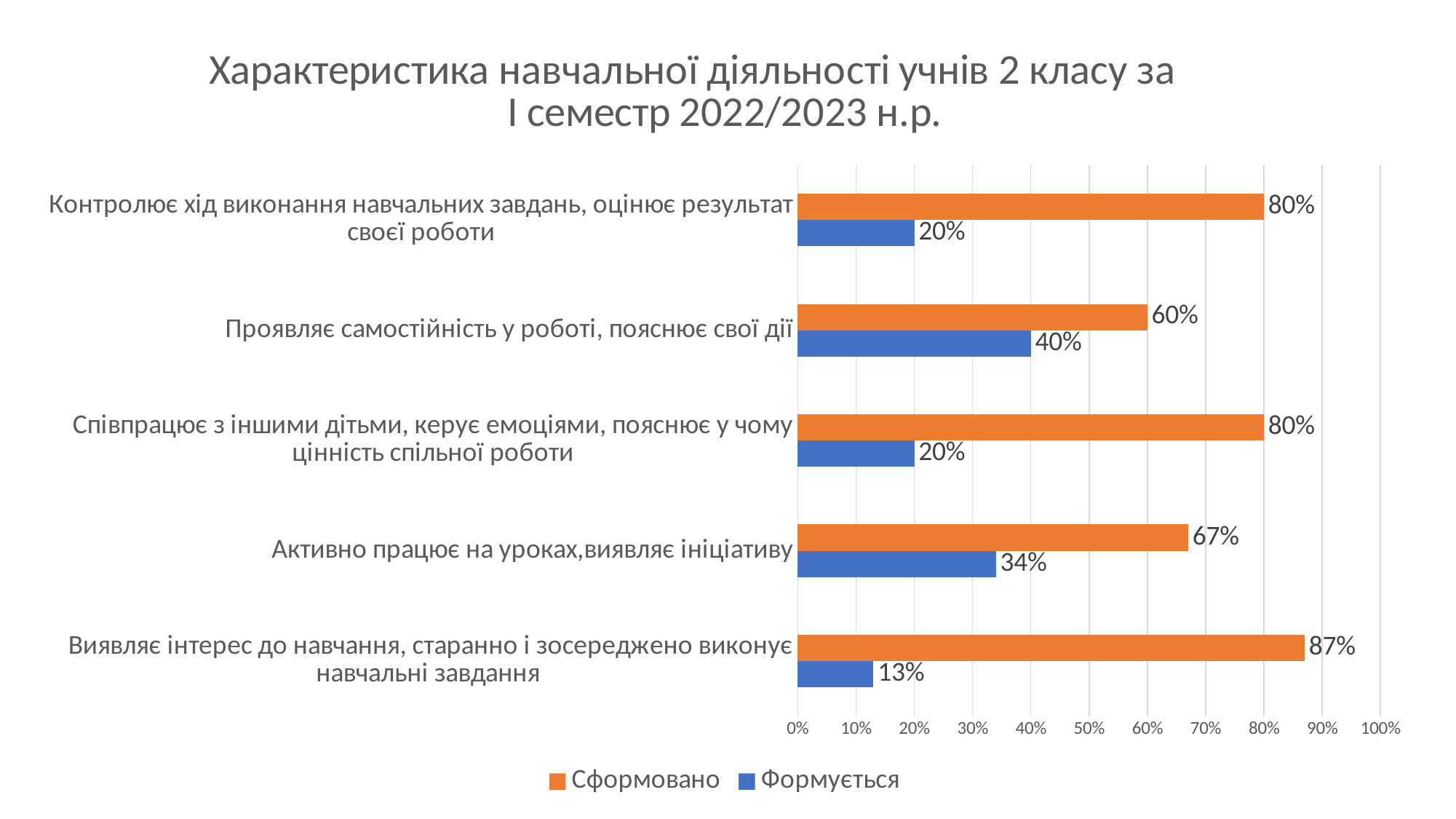
How many categories are shown on the chart? 5 Which category has the lowest "Сформовано" value? Проявляє самостійність у роботі, пояснює свої дії What kind of chart is shown on the slide? Bar chart What is the difference between the "Сформовано" and "Формується" values for "Активно працює на уроках,виявляє ініціативу"? 33% How many series does the legend list? 2 Which colour represents the "Формується" series? Blue Which is larger: the "Формується" value for "Проявляє самостійність у роботі, пояснює свої дії" or for "Контролює хід виконання навчальних завдань, оцінює результат своєї роботи"? Проявляє самостійність у роботі, пояснює свої дії What is the "Формується" value for "Проявляє самостійність у роботі, пояснює свої дії"? 40% Which category has the highest "Сформовано" value? Виявляє інтерес до навчання, старанно і зосереджено виконує навчальні завдання What is the "Сформовано" value for "Активно працює на уроках,виявляє ініціативу"? 67% Which category has the highest "Формується" value? Проявляє самостійність у роботі, пояснює свої дії What is the "Формується" value for "Виявляє інтерес до навчання, старанно і зосереджено виконує навчальні завдання"? 13%